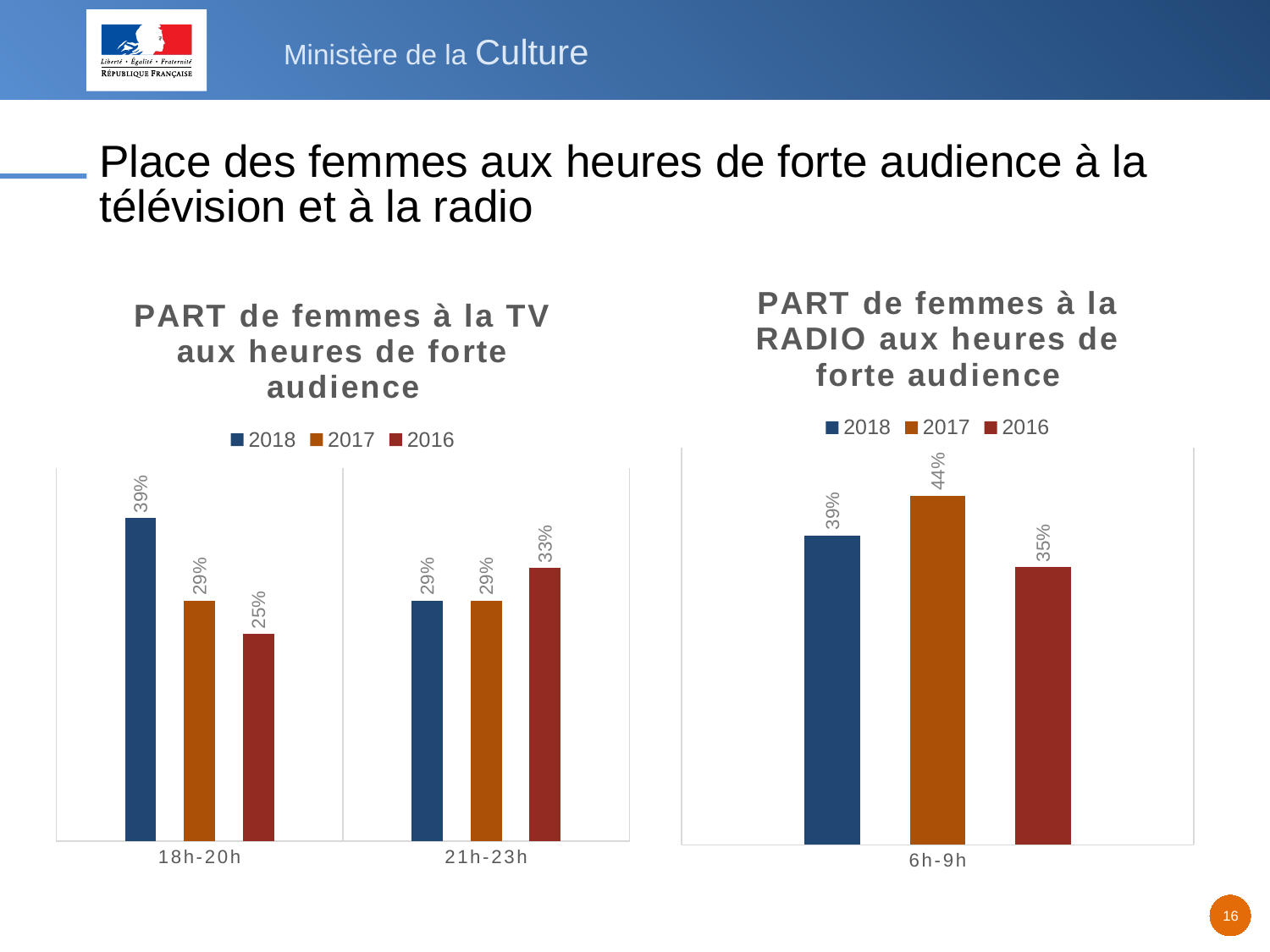
In the TV chart (left), which is larger for 21h-23h: the 2018 value or the 2016 value? 2016 How many time-slot categories does the TV chart (left) show? 2 In the TV chart (left), what is the share of women for 2018 in the 18h-20h slot? 39% How many series does the legend of the RADIO chart (right) list? 3 In the TV chart (left), what is the difference between the 2018 and 2016 values for 18h-20h? 14 percentage points In the TV chart (left), which colour represents the year 2017? Orange In the TV chart (left), what is the share of women for 2016 in the 21h-23h slot? 33% In the RADIO chart (right), what is the difference between the 2017 and 2016 values? 9 percentage points In the TV chart (left), which year has the lowest share of women in the 18h-20h slot? 2016 In the RADIO chart (right), which year has the highest share of women? 2017 What type of chart is the RADIO chart (right)? Bar chart In the RADIO chart (right), what is the share of women for 2017 in the 6h-9h slot? 44%